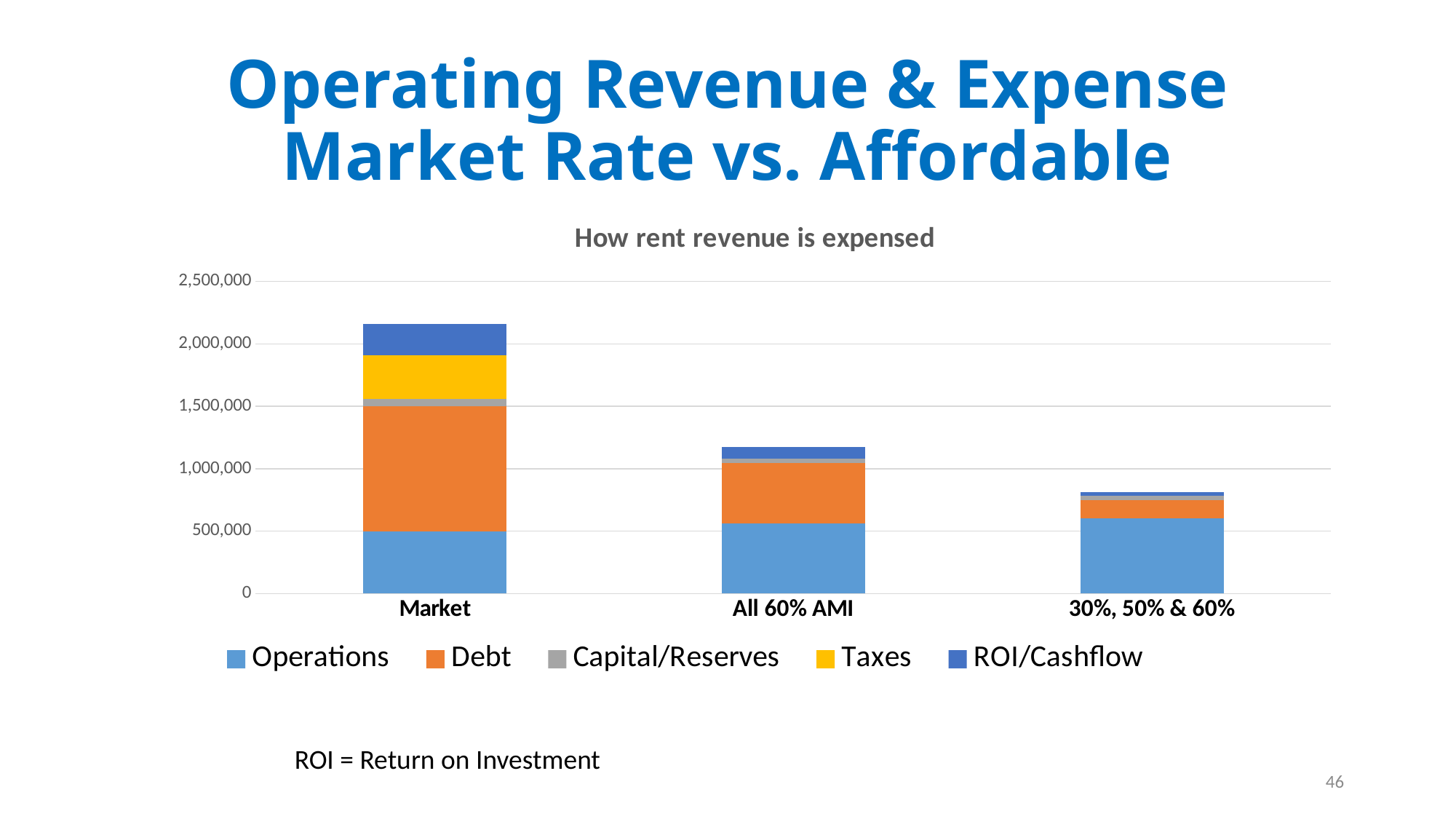
Is the total of the All 60% AMI bar greater or less than 1,000,000? greater How many series does the legend list? 5 Which series is shown in yellow in the legend? Taxes What kind of chart is shown on the slide? Stacked bar chart Which category has the shortest stacked bar? 30%, 50% & 60% What is the title of the chart? How rent revenue is expensed Do the bar totals rise or fall from left to right along the x axis? fall Is the total of the 30%, 50% & 60% bar greater or less than 1,000,000? less Is the total of the Market bar greater or less than 2,000,000? greater Which stacked bar is taller, Market or All 60% AMI? Market Which category has the tallest stacked bar? Market How many categories are shown on the x axis? 3